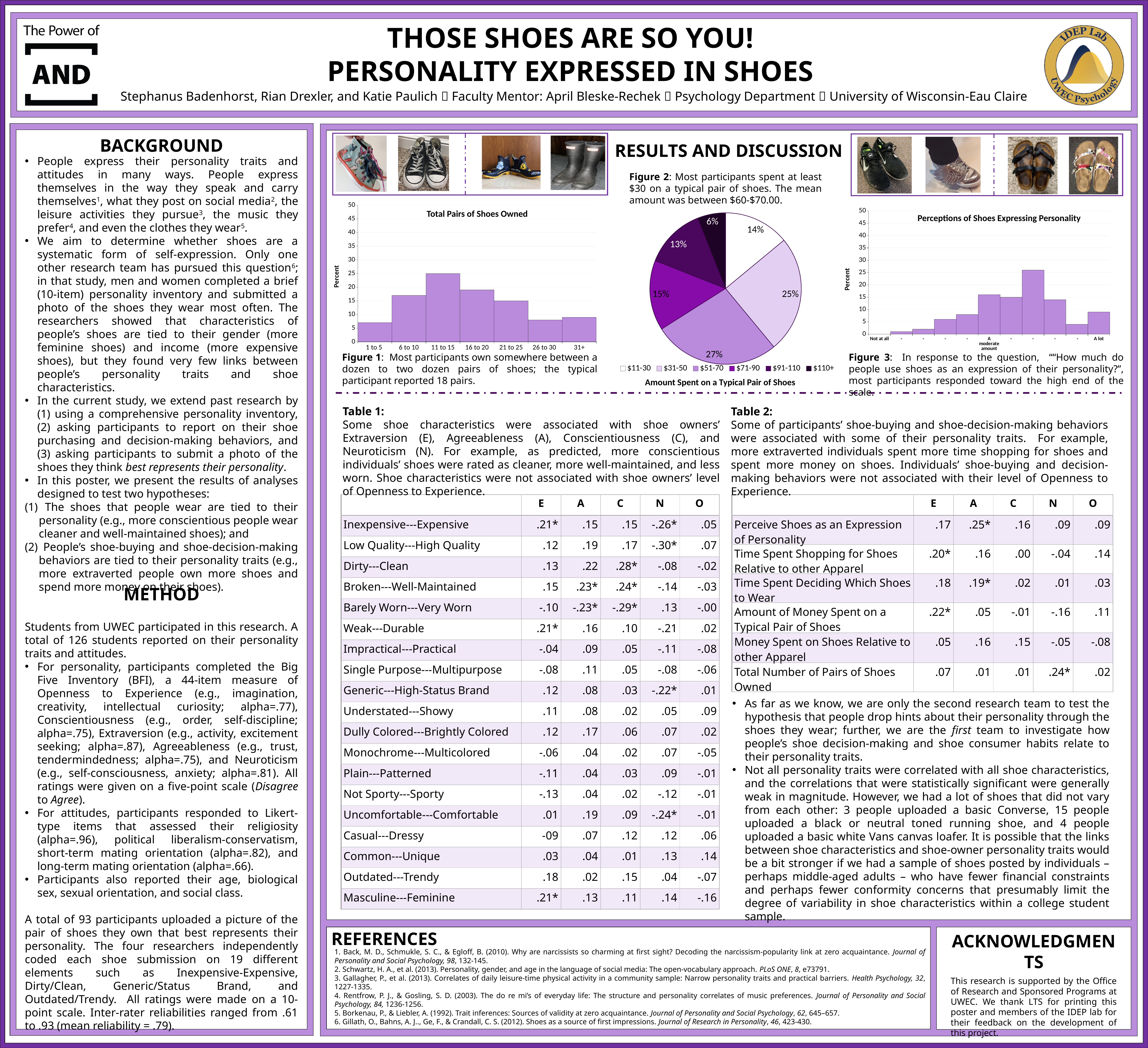
In the pie chart 'Amount Spent on a Typical Pair of Shoes', which spending category has the largest slice? $51-70 In the pie chart 'Amount Spent on a Typical Pair of Shoes', how many percentage points larger is the $31-50 slice than the $11-30 slice? 11% In the 'Total Pairs of Shoes Owned' chart, is the value for '1 to 5' greater or less than 10? less How many spending categories does the legend of the pie chart 'Amount Spent on a Typical Pair of Shoes' list? 6 In the 'Total Pairs of Shoes Owned' chart, which has the larger value, '6 to 10' or '26 to 30'? 6 to 10 In the 'Perceptions of Shoes Expressing Personality' chart, is the value for 'A lot' greater or less than 5? greater How many categories are shown on the x axis of the 'Total Pairs of Shoes Owned' chart? 7 In the 'Total Pairs of Shoes Owned' chart, which category has the highest bar? 11 to 15 In the pie chart 'Amount Spent on a Typical Pair of Shoes', what percentage of participants spent $51-70? 27% What kind of chart is 'Total Pairs of Shoes Owned'? bar chart In the pie chart 'Amount Spent on a Typical Pair of Shoes', which spending category has the smallest slice? $110+ In the 'Perceptions of Shoes Expressing Personality' chart, is the value for 'Not at all' greater or less than 5? less